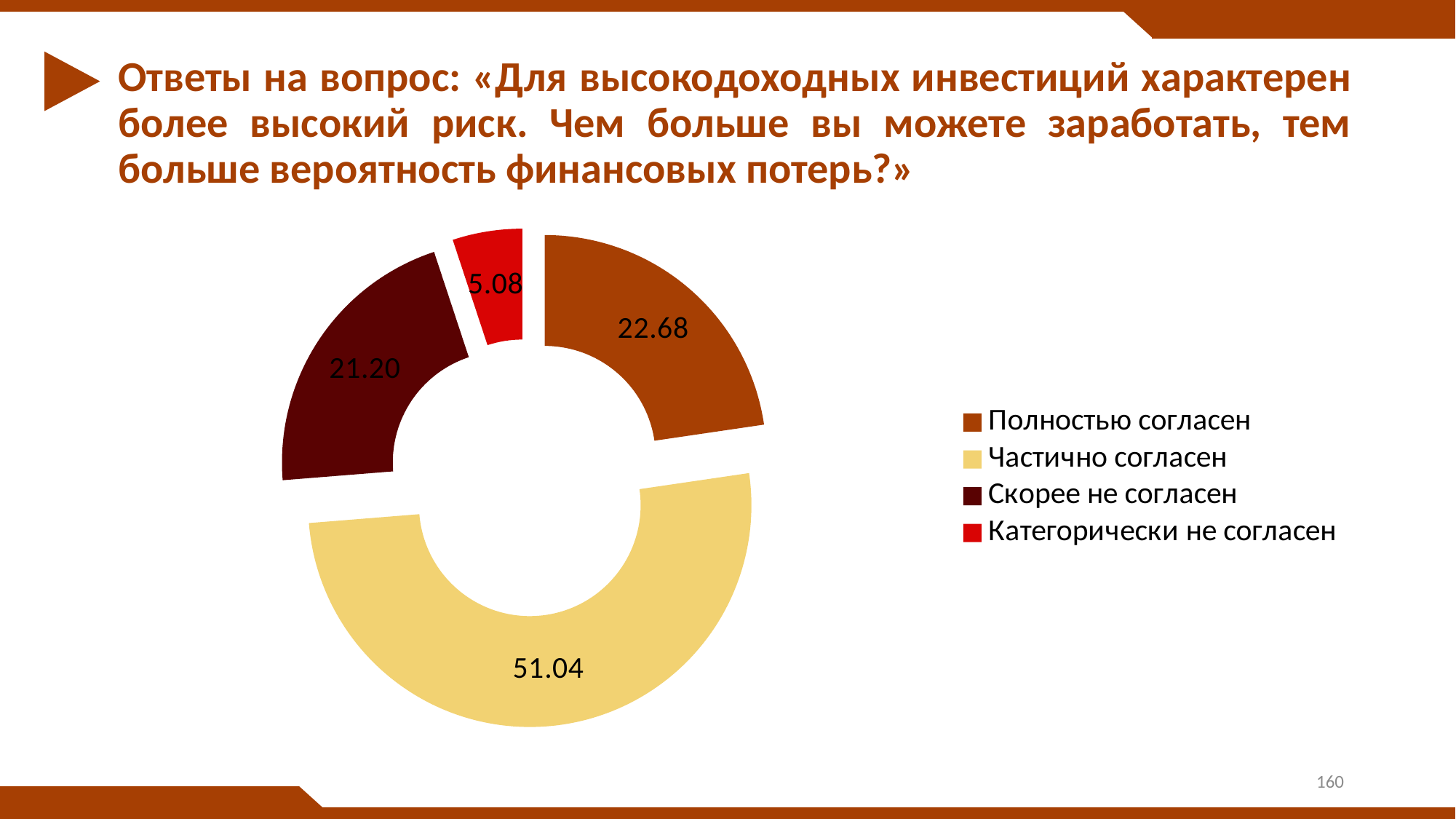
How many categories does the chart show? 4 What value is shown for «Частично согласен»? 51.04 Which is larger: the value for «Полностью согласен» or for «Скорее не согласен»? Полностью согласен Which category has the smallest slice? Категорически не согласен What kind of chart is shown on the slide? Doughnut (pie) chart What is the difference between the values for «Частично согласен» and «Полностью согласен»? 28.36 What is the difference between the values for «Скорее не согласен» and «Категорически не согласен»? 16.12 Which category has the largest slice? Частично согласен What value is shown for «Категорически не согласен»? 5.08 What value is shown for «Скорее не согласен»? 21.20 What colour is the slice for «Категорически не согласен»? Red What value is shown for «Полностью согласен»? 22.68